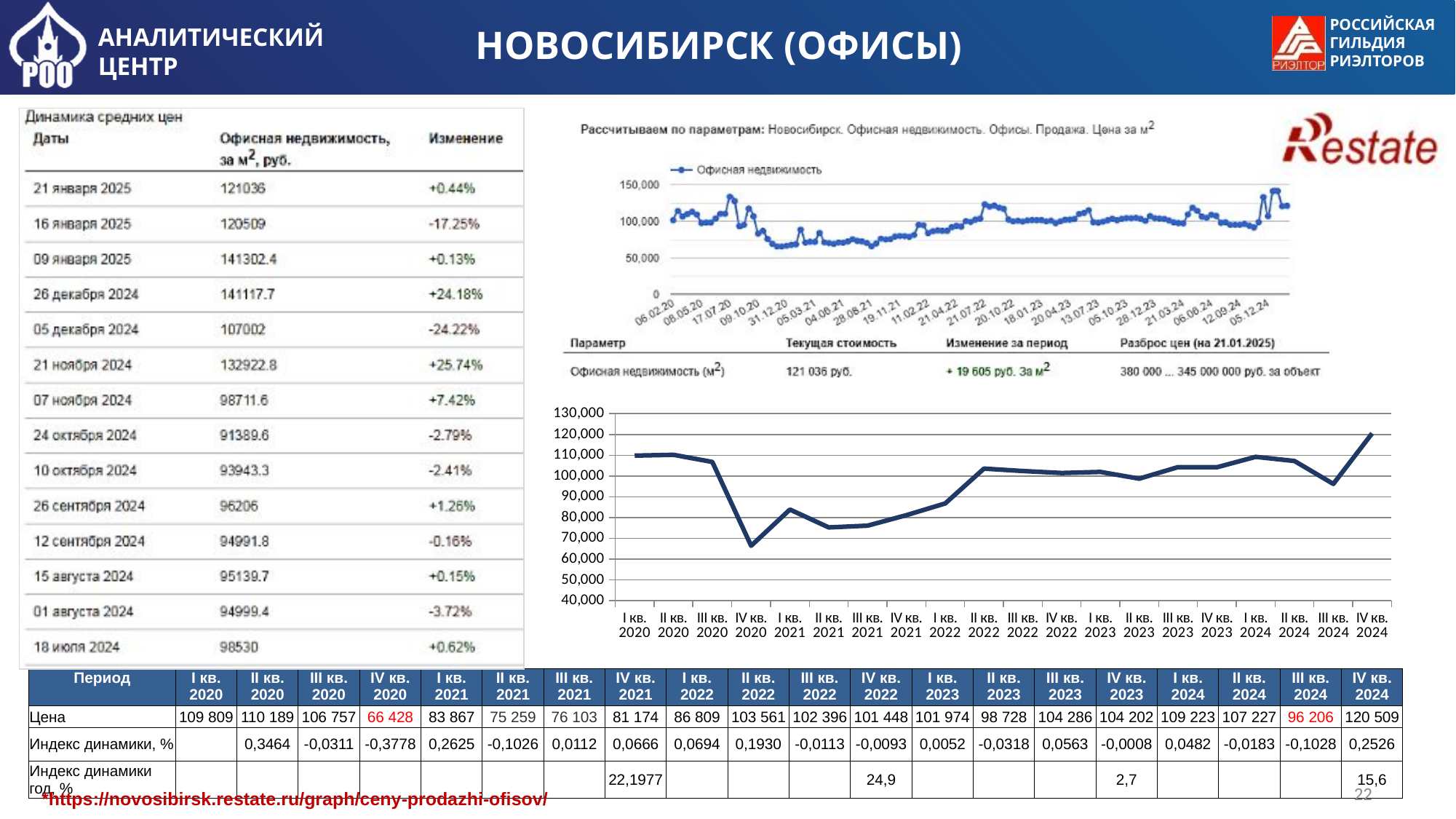
In the lower quarterly chart, what is the difference between the values for IV кв. 2024 and III кв. 2024? 24 303 In the lower quarterly chart, is the value for IV кв. 2020 greater or less than 70,000? less In the lower quarterly chart, which quarter has the lowest value? IV кв. 2020 In the lower quarterly chart, what is the value for III кв. 2024? 96 206 In the lower quarterly chart, how many quarterly points are plotted? 20 What kind of chart is the lower chart on the right side of the slide (quarterly prices from I кв. 2020 to IV кв. 2024)? line chart In the lower quarterly chart, what is the value for IV кв. 2024? 120 509 In the lower quarterly chart, which is larger: the value for I кв. 2020 or the value for I кв. 2021? I кв. 2020 In the lower quarterly chart, which quarter has the highest value? IV кв. 2024 In the lower quarterly chart, what is the value for IV кв. 2020? 66 428 In the lower quarterly chart, do the values rise or fall from III кв. 2024 to IV кв. 2024? rise In the upper Restate chart, how many series does the legend list? 1